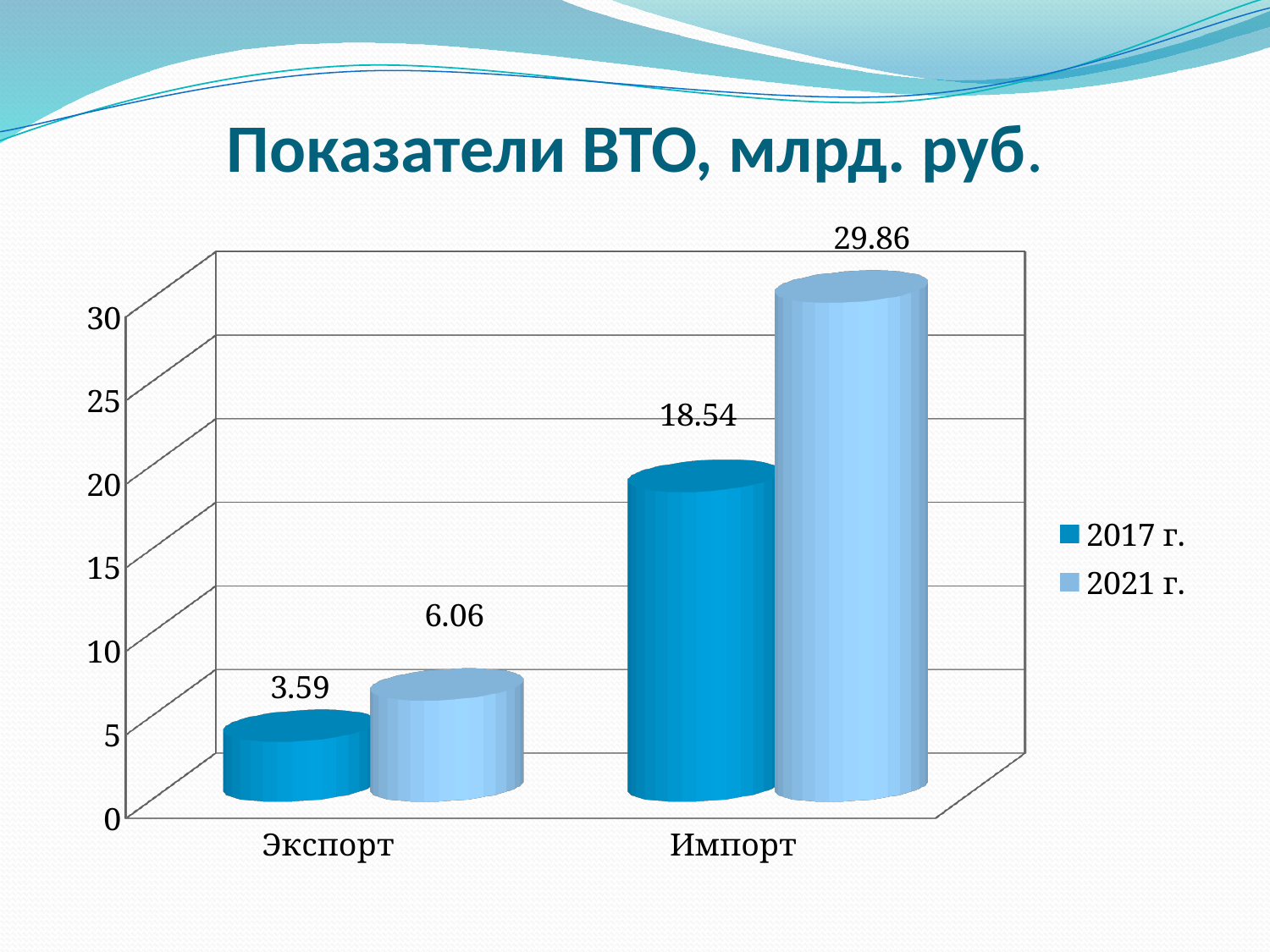
What kind of chart is shown on the slide? Bar chart Which is larger: Импорт in 2017 г. or Экспорт in 2021 г.? Импорт in 2017 г. What is the value for Импорт in 2017 г.? 18.54 How many categories are shown on the x axis? 2 Which category has the lowest value in 2017 г.? Экспорт How many series does the legend list? 2 What is the value for Экспорт in 2021 г.? 6.06 What is the value for Импорт in 2021 г.? 29.86 What is the difference between the 2021 г. and 2017 г. values for Импорт? 11.32 What is the value for Экспорт in 2017 г.? 3.59 What is the difference between the 2021 г. and 2017 г. values for Экспорт? 2.47 Which category has the highest value in 2021 г.? Импорт